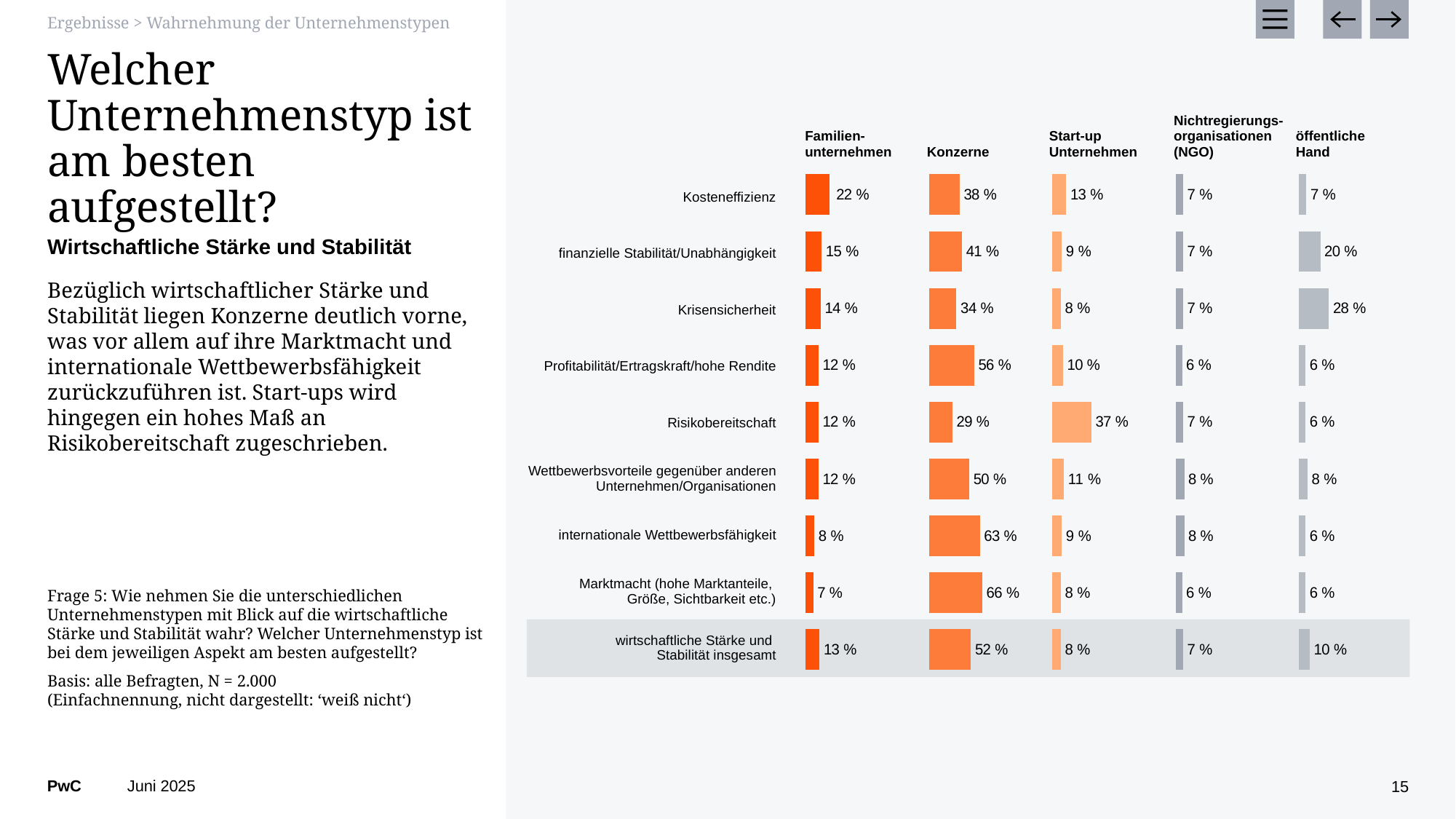
For Risikobereitschaft, which is larger: the value for Start-up Unternehmen or the value for Konzerne? Start-up Unternehmen Which company type has the highest value for internationale Wettbewerbsfähigkeit? Konzerne What value is shown for Konzerne on wirtschaftliche Stärke und Stabilität insgesamt? 52 % What is the difference between the Konzerne and Familienunternehmen values for Profitabilität/Ertragskraft/hohe Rendite? 44 percentage points What value is shown for Familienunternehmen on Kosteneffizienz? 22 % How many company types (series) are shown in the chart? 5 What value is shown for Start-up Unternehmen on Risikobereitschaft? 37 % Which company type has the lowest value for Kosteneffizienz? Nichtregierungsorganisationen (NGO) and öffentliche Hand (both 7 %) What percentage is shown for Konzerne on Marktmacht (hohe Marktanteile, Größe, Sichtbarkeit etc.)? 66 % What kind of chart is shown on the slide? Bar chart How many aspects (rows) are shown in the chart? 9 What value is shown for öffentliche Hand on Krisensicherheit? 28 %